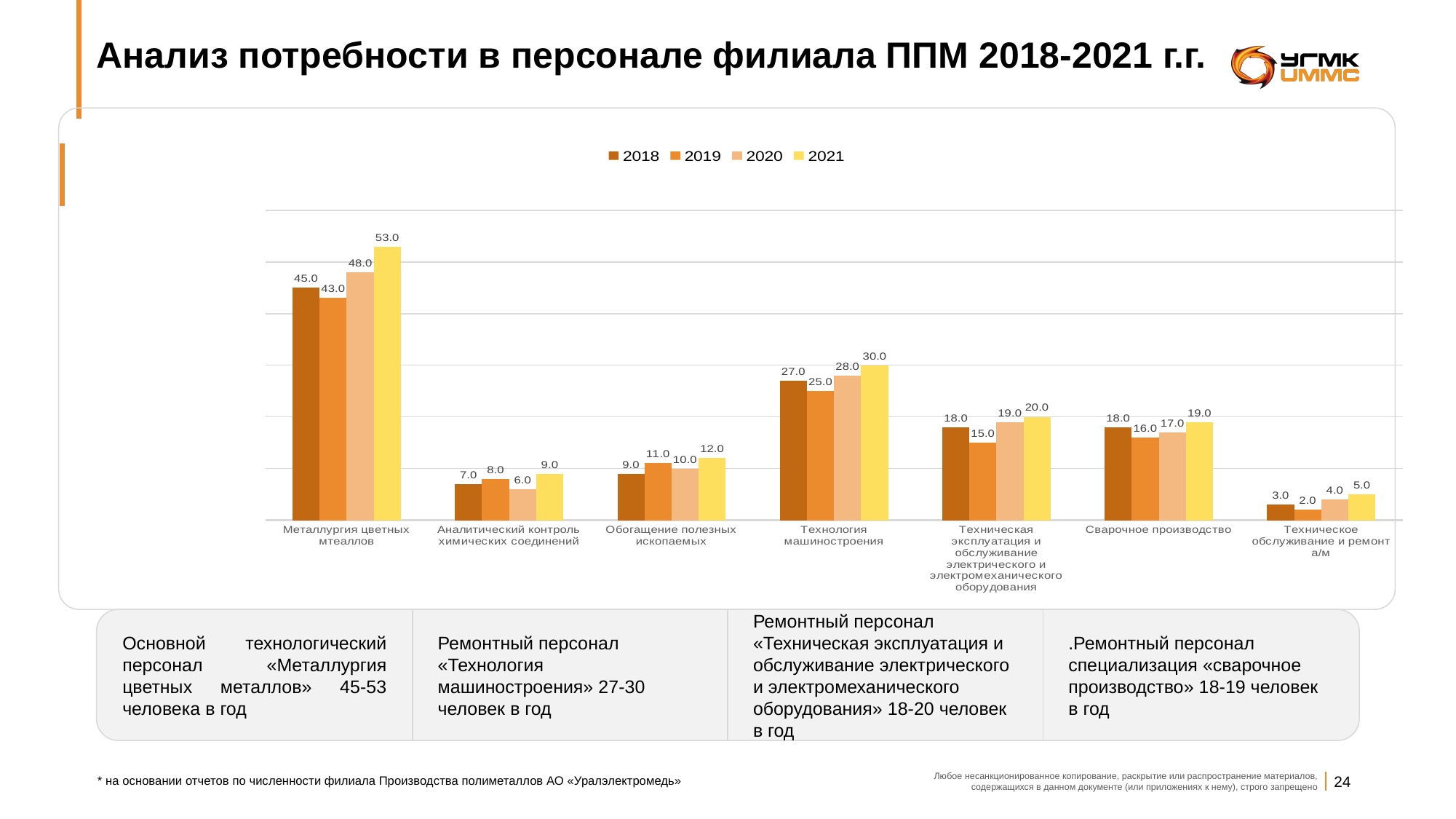
Which legend entry is shown in yellow? 2021 Which is larger for «Сварочное производство»: the 2018 value or the 2019 value? 2018 How many categories are shown on the x axis? 7 Which category has the lowest value for 2019? Техническое обслуживание и ремонт а/м What is the value for 2021 in the category «Металлургия цветных мтеаллов»? 53.0 What is the value for 2020 in the category «Аналитический контроль химических соединений»? 6.0 Do the values for «Техническое обслуживание и ремонт а/м» rise or fall from 2019 to 2021? rise What is the value for 2019 in the category «Технология машиностроения»? 25.0 What is the difference between the 2021 and 2018 values for «Металлургия цветных мтеаллов»? 8.0 What type of chart is shown on the slide? bar chart Which category has the highest value for 2018? Металлургия цветных мтеаллов How many series does the legend list? 4